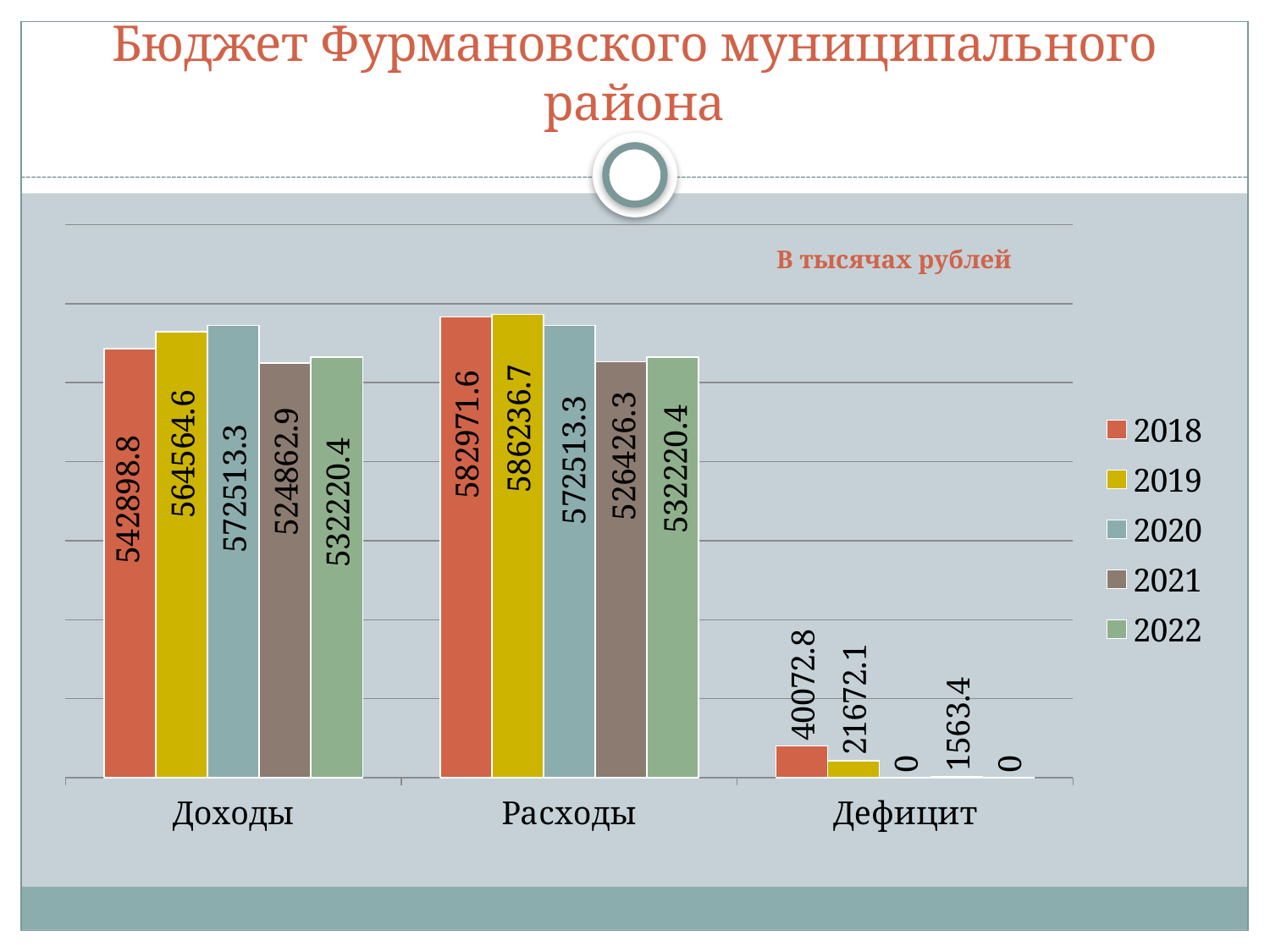
Which year has the highest value for Дефицит? 2018 Which is larger: Доходы in 2019 or Доходы in 2022? Доходы in 2019 What is the value for Дефицит in 2021? 1563.4 How many categories are shown on the x axis? 3 Which year has the highest value for Доходы? 2020 Which year has the lowest value for Доходы? 2021 What is the value for Расходы in 2019? 586236.7 What is the difference between Расходы and Доходы in 2018? 40072.8 What type of chart is shown on the slide? bar chart In what units are the values given, according to the note on the chart? В тысячах рублей How many series does the legend list? 5 What is the value for Доходы in 2020? 572513.3